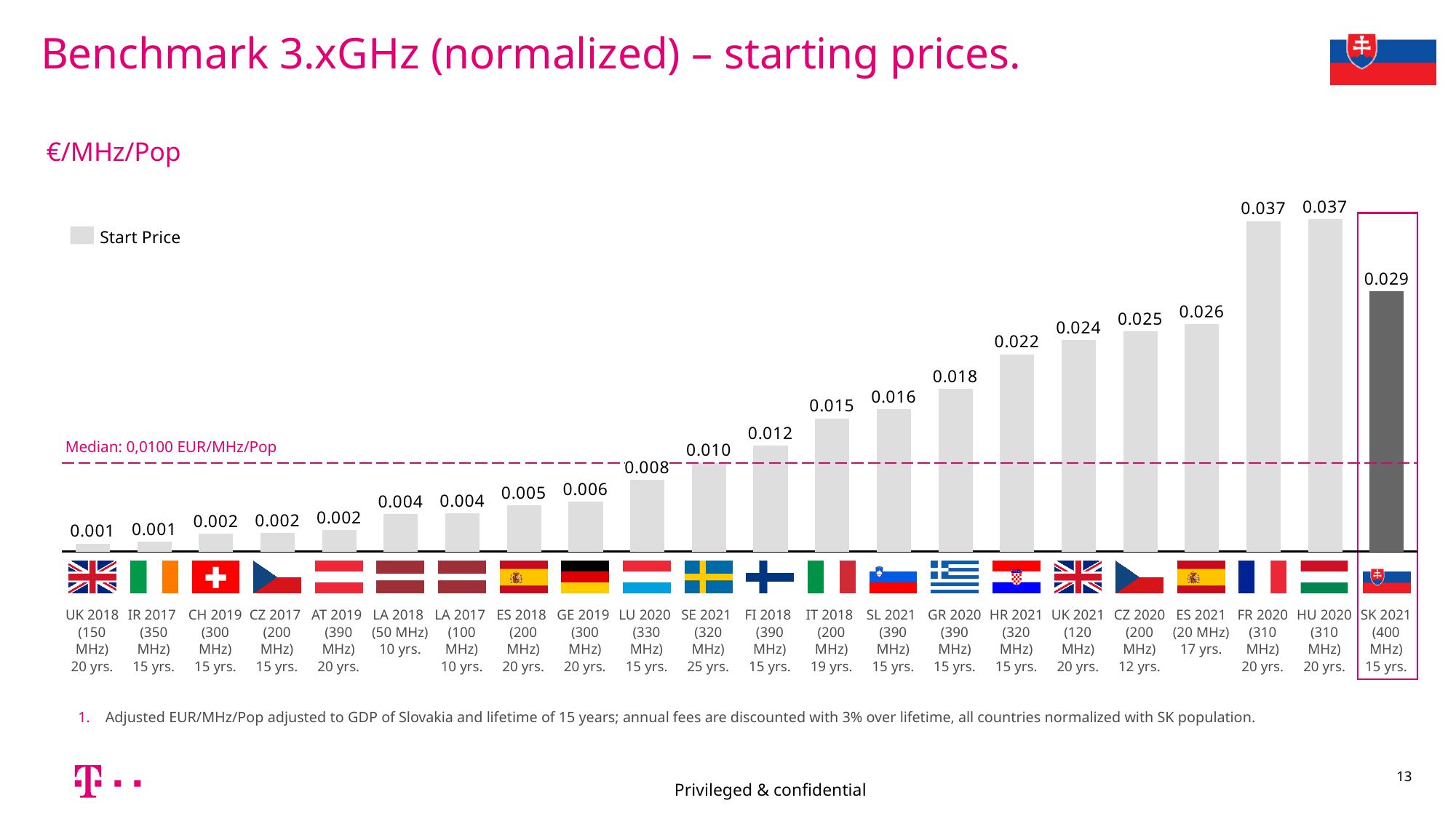
What is the start price for SE 2021? 0.010 How many countries/auctions are shown on the chart? 22 What is the start price for SK 2021? 0.029 What is the difference between the start price for HU 2020 and SK 2021? 0.008 Which has a higher start price, IT 2018 or SL 2021? SL 2021 What is the start price for GR 2020? 0.018 How many series does the legend list? 1 What is the start price for FI 2018? 0.012 What median value is marked by the dashed line on the chart? 0,0100 EUR/MHz/Pop What kind of chart is shown on the slide? Bar chart What is the difference between the start price for CZ 2020 and CZ 2017? 0.023 What is the highest start price shown on the chart? 0.037